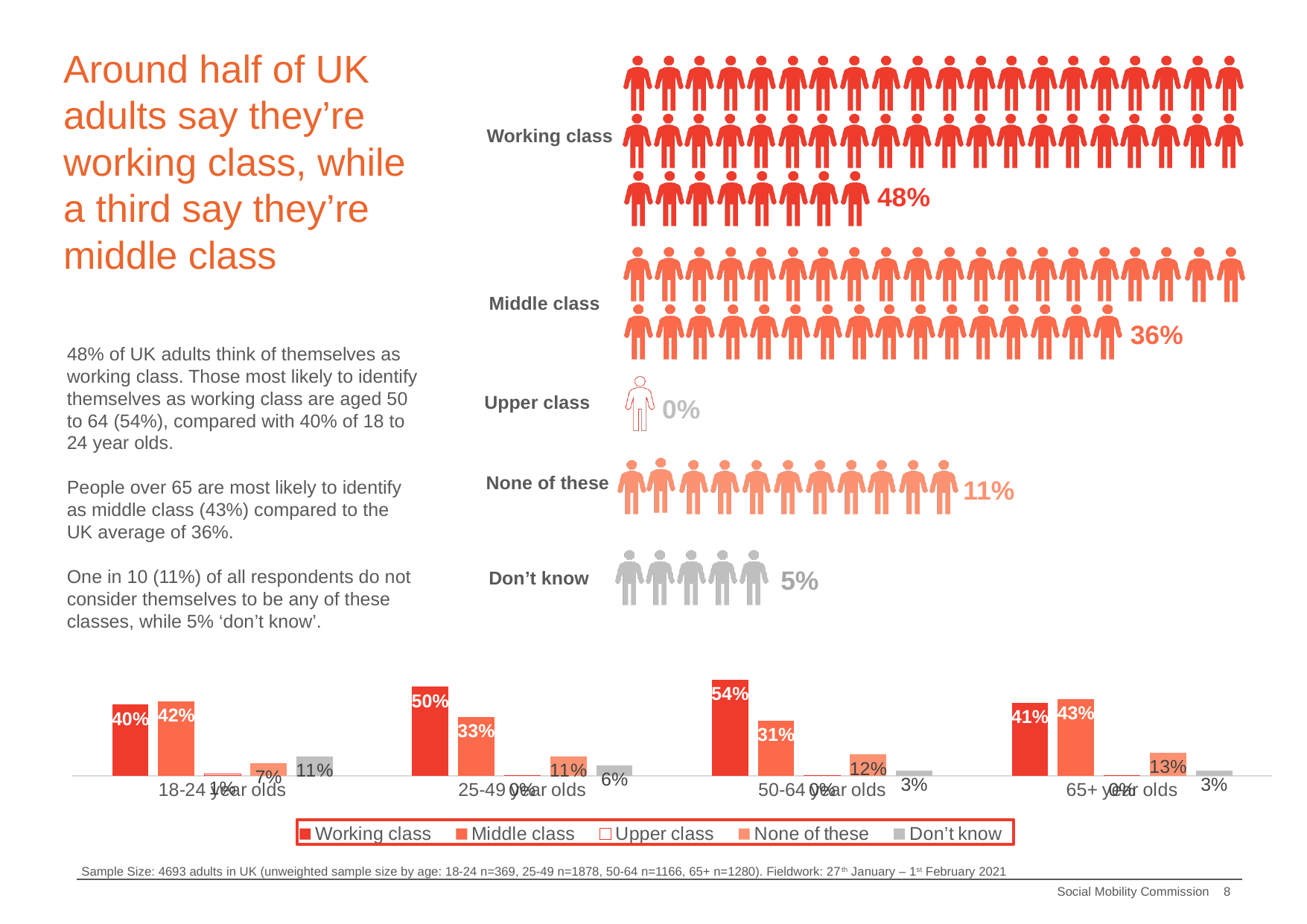
In the pictogram chart on the right, which category has the lowest percentage? Upper class What kind of chart is shown at the bottom of the slide? Bar chart In the pictogram chart on the right, what percentage identify as middle class? 36% In the pictogram chart on the right, what is the difference between the working class and middle class percentages? 12% In the bar chart at the bottom, what percentage of 50-64 year olds identify as working class? 54% In the bar chart at the bottom, is the working class value or the middle class value larger for 18-24 year olds? Middle class In the pictogram chart on the right, how many categories are shown? 5 In the bar chart at the bottom, how many series does the legend list? 5 In the bar chart at the bottom, what percentage of 65+ year olds identify as middle class? 43% In the pictogram chart on the right, what percentage of UK adults identify as working class? 48% In the bar chart at the bottom, which age group has the highest working class percentage? 50-64 year olds In the bar chart at the bottom, what is the difference between the 'Don't know' values for 18-24 year olds and 65+ year olds? 8%